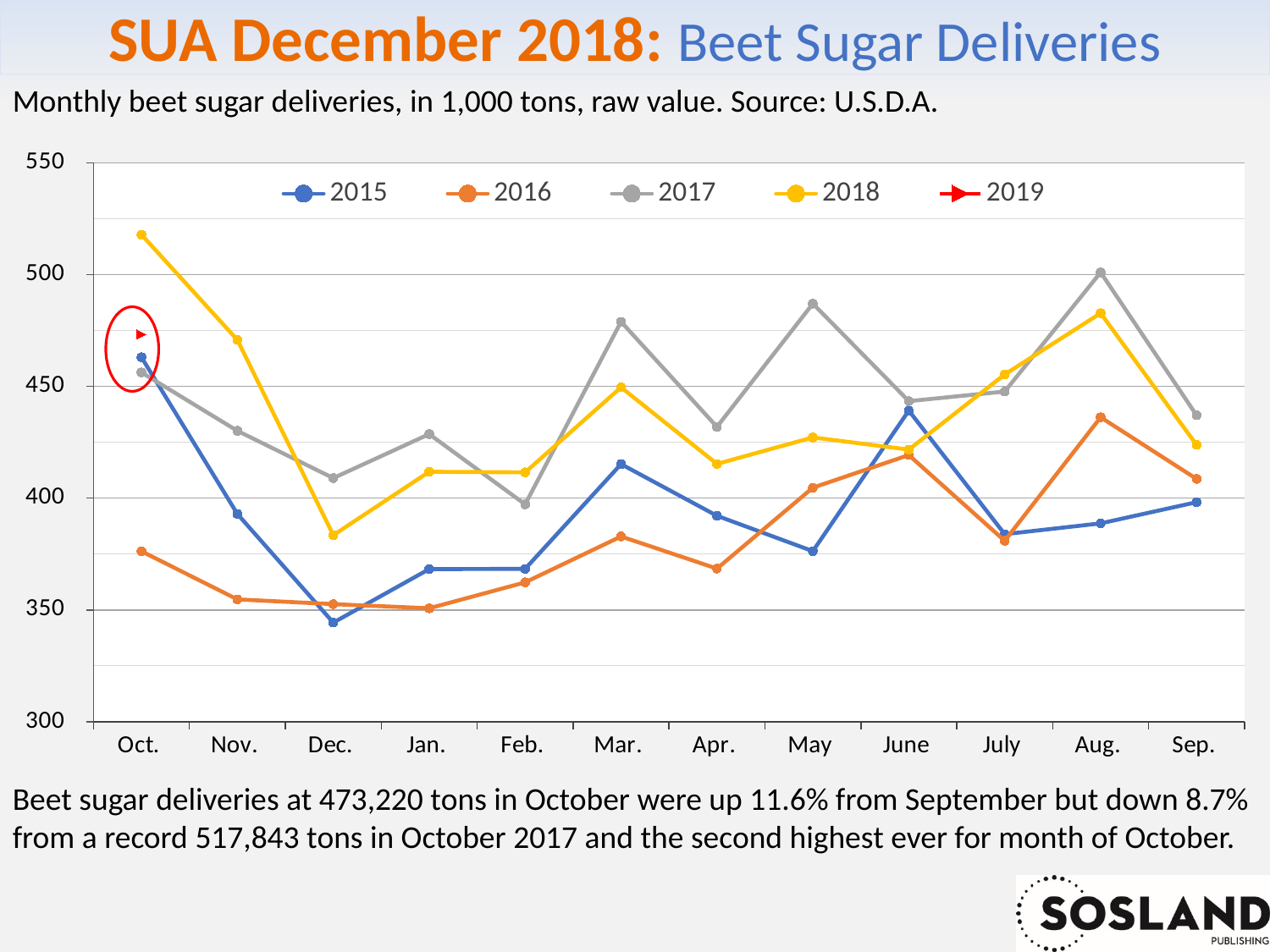
How many series does the legend list? 5 What kind of chart is shown on the slide? line chart In which month does the 2018 series reach its highest value? Oct. Is the value for 2018 in Oct. greater or less than 500? greater Does the 2018 series rise or fall from Oct. to Dec.? fall How many months are shown along the x axis? 12 Is the value for 2016 in Oct. greater or less than 400? less In which month does the 2015 series reach its lowest value? Dec. Which series is drawn in red in the legend? 2019 Is the value for 2017 in May greater or less than 450? greater In Oct., which series has the larger value, 2017 or 2018? 2018